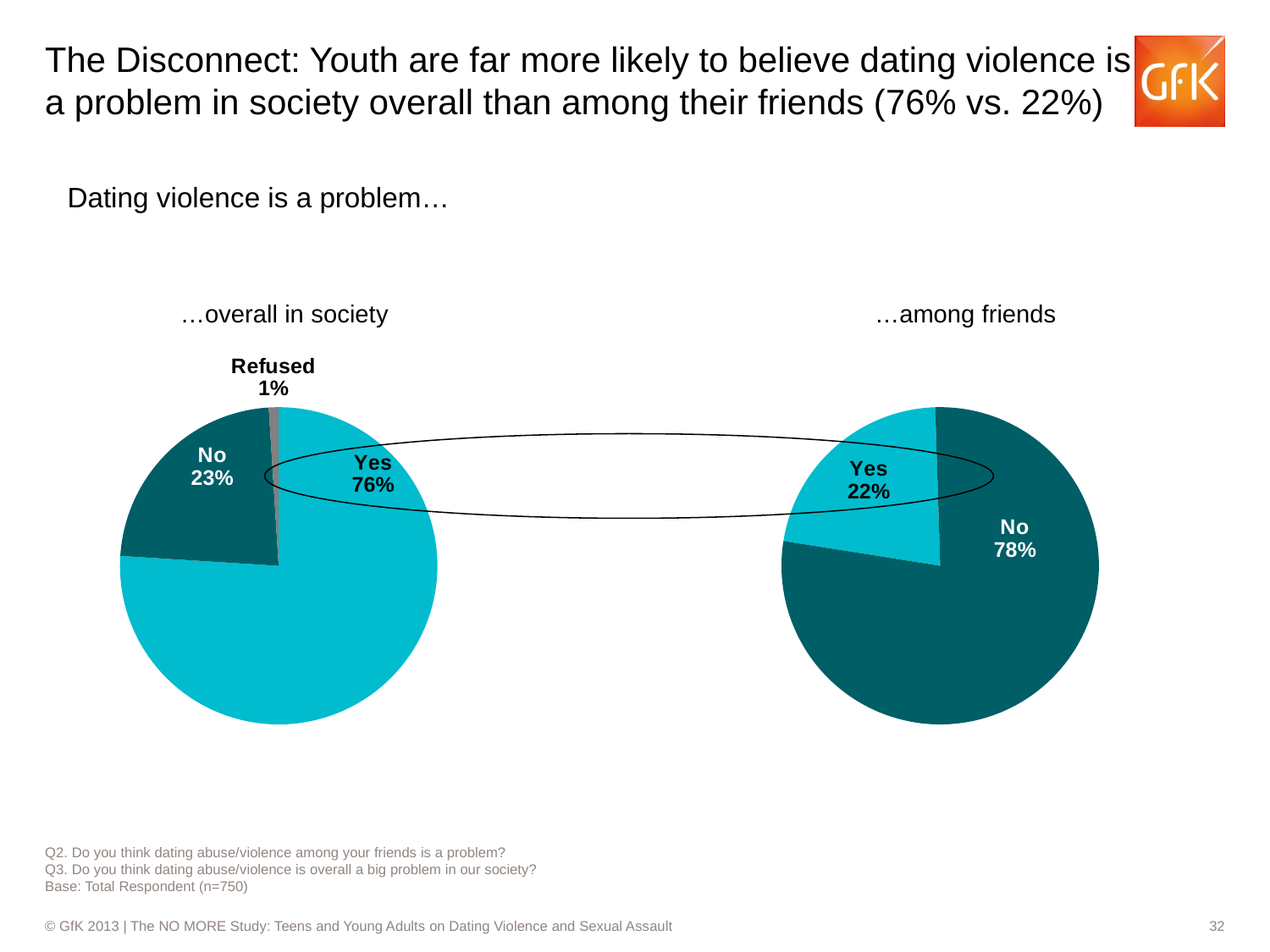
What is the difference between the Yes share in the '…overall in society' chart and the Yes share in the '…among friends' chart? 54 percentage points In the '…among friends' pie chart, what percentage answered Yes? 22% How many slices does the '…overall in society' pie chart have? 3 In the '…among friends' pie chart, what percentage answered No? 78% In the '…overall in society' pie chart, which slice is the largest? Yes In the '…among friends' pie chart, which slice is the largest? No What type of chart is used on this slide? Pie chart In the '…overall in society' pie chart, what percentage answered No? 23% In the '…overall in society' pie chart, which slice is the smallest? Refused In the '…overall in society' pie chart, what percentage Refused? 1% Which is larger: the No share in the '…among friends' chart or the No share in the '…overall in society' chart? No in '…among friends' (78%) In the '…overall in society' pie chart, what percentage answered Yes? 76%